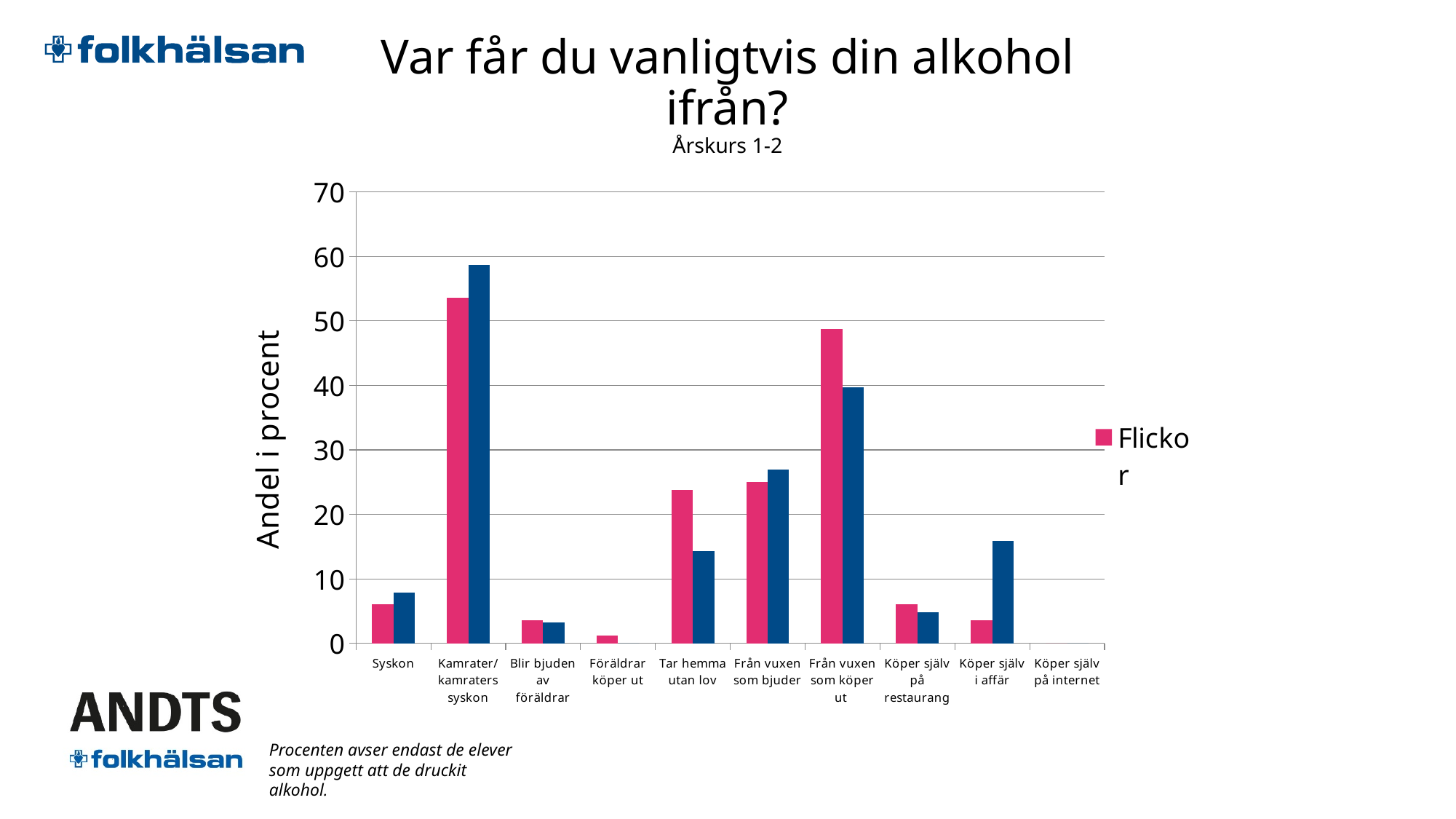
Is the Flickor value for Kamrater/kamraters syskon greater or less than 50? greater For Flickor, which is larger: Kamrater/kamraters syskon or Från vuxen som köper ut? Kamrater/kamraters syskon Is the blue series value for Köper själv i affär greater or less than 10? greater How many categories are shown on the x axis of the chart? 10 Is the Flickor value for Från vuxen som köper ut greater or less than 40? greater Which category has the highest value for Flickor? Kamrater/kamraters syskon What kind of chart is shown on the slide? bar chart What is the title of the chart? Var får du vanligtvis din alkohol ifrån? What is the label of the vertical axis? Andel i procent For Tar hemma utan lov, which is larger: the Flickor bar or the blue bar? Flickor